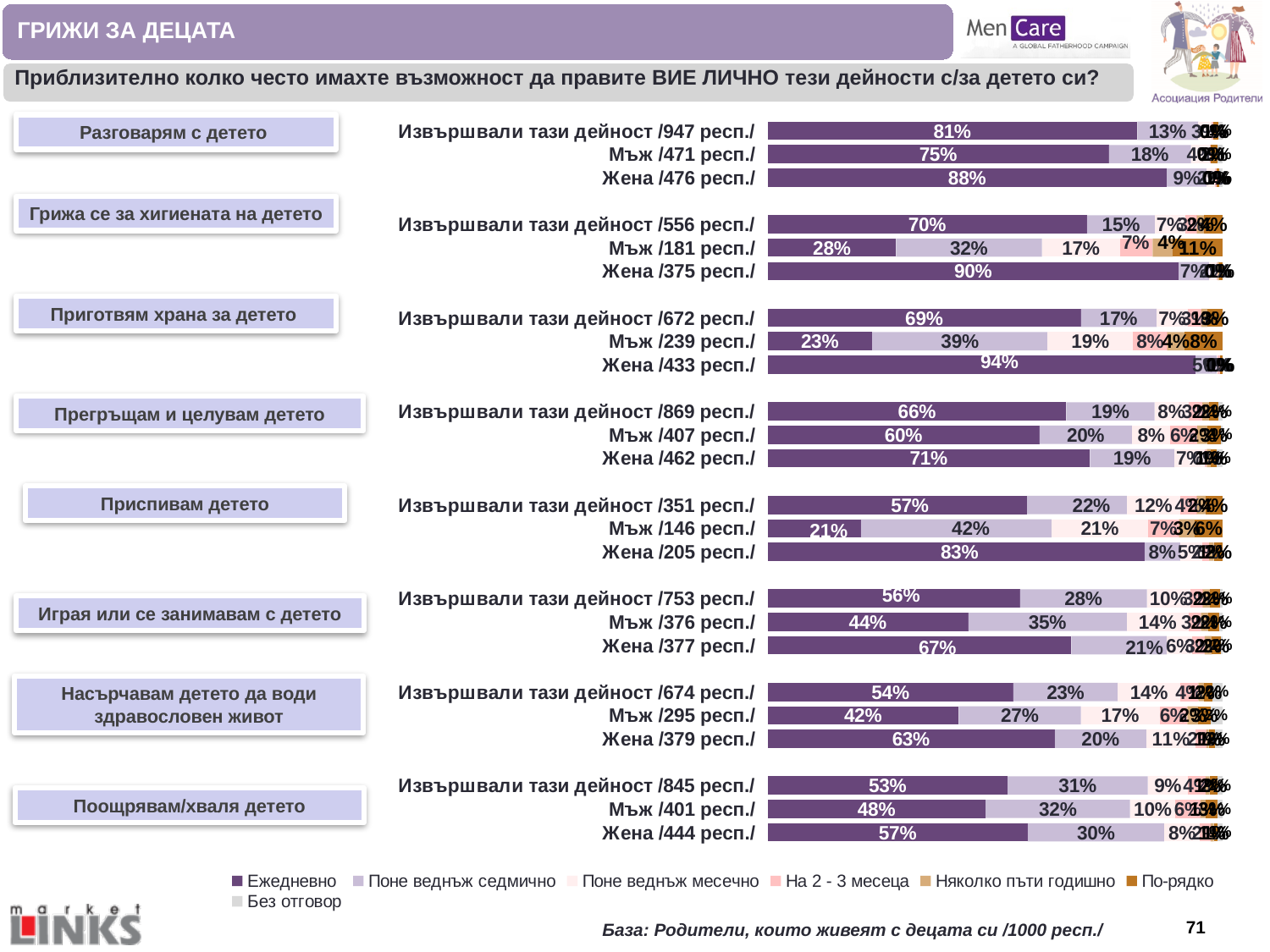
What percentage of all respondents who talk with the child (Разговарям с детето, 947 resp.) do so daily (Ежедневно)? 81% What is the 'Поне веднъж седмично' share for men (Мъж /239 респ./) in the activity Приготвям храна за детето? 39% Which bar has the highest daily (Ежедневно) share on the slide? Жена /433 респ./ in Приготвям храна за детето (94%) How many series does the legend list? 7 What is the daily (Ежедневно) share for women (Жена /433 респ./) in the activity Приготвям храна за детето? 94% What kind of chart is shown on the slide? Stacked horizontal bar chart What is the 'Поне веднъж седмично' share for all respondents (845 респ.) in the activity Поощрявам/хваля детето? 31% How many activities (groups of bars) are shown on the slide? 8 Among the 'Извършвали тази дейност' rows, which activity has the lowest daily (Ежедневно) share? Поощрявам/хваля детето (53%) For Разговарям с детето, what is the difference in percentage points between the daily share of women (88%) and men (75%)? 13 percentage points For Грижа се за хигиената на детето, who has the larger daily (Ежедневно) share: men (Мъж) or women (Жена)? Жена What is the daily (Ежедневно) share for men (Мъж /376 респ./) in the activity Играя или се занимавам с детето? 44%